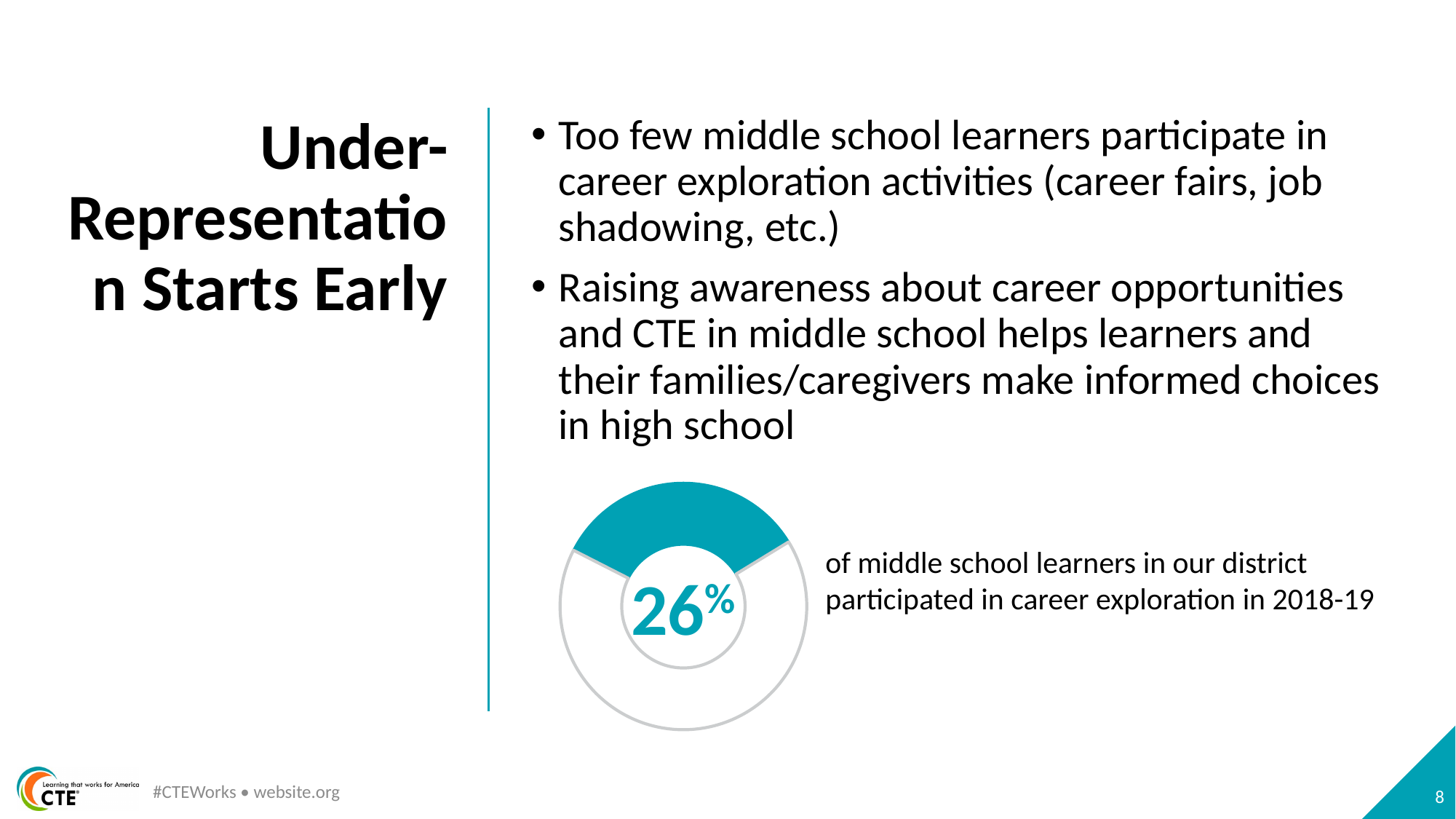
What share of the donut chart does the teal (highlighted) segment represent? 26% What percentage of middle school learners in the district participated in career exploration in 2018-19, according to the chart? 26% Which school year does the chart's statistic refer to? 2018-19 Which segment of the donut chart is larger, the teal segment or the grey segment? The grey segment How many segments does the donut chart have? 2 What value is printed in the centre of the donut chart? 26% What colour is the segment representing the 26% value in the donut chart? Teal What kind of chart is shown on the slide? Donut chart